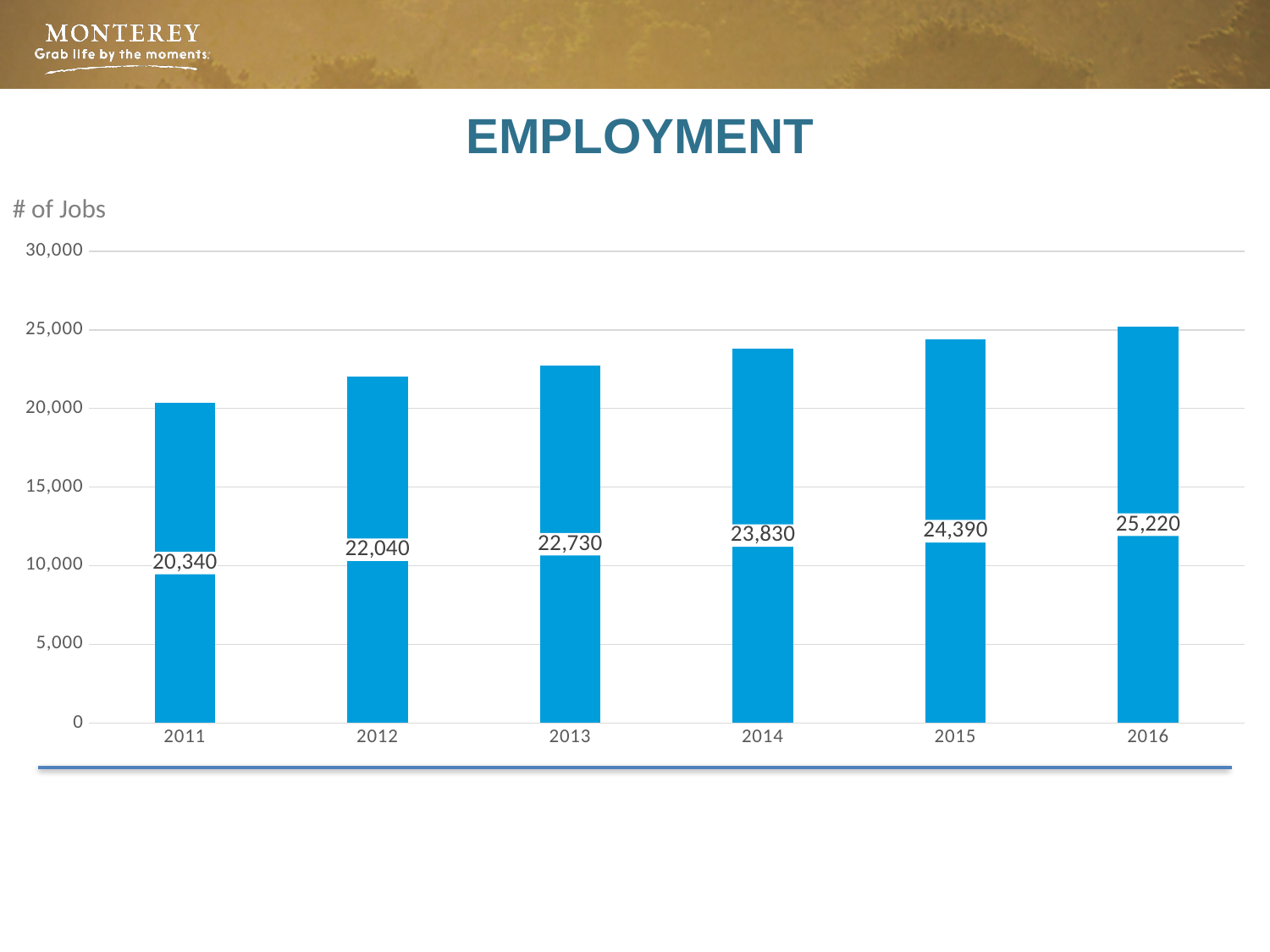
Is the number of jobs in 2016 greater or less than 25,000? greater What is the difference in the number of jobs between 2013 and 2012? 690 What is the difference in the number of jobs between 2016 and 2011? 4,880 What kind of chart is shown on the slide? Bar chart Which year has the lowest number of jobs? 2011 Which year has the highest number of jobs? 2016 Which year has more jobs, 2013 or 2015? 2015 What is the number of jobs in 2016? 25,220 Do the number of jobs rise or fall from 2011 to 2016? Rise What is the number of jobs in 2014? 23,830 How many years are shown on the chart? 6 What is the number of jobs in 2011? 20,340